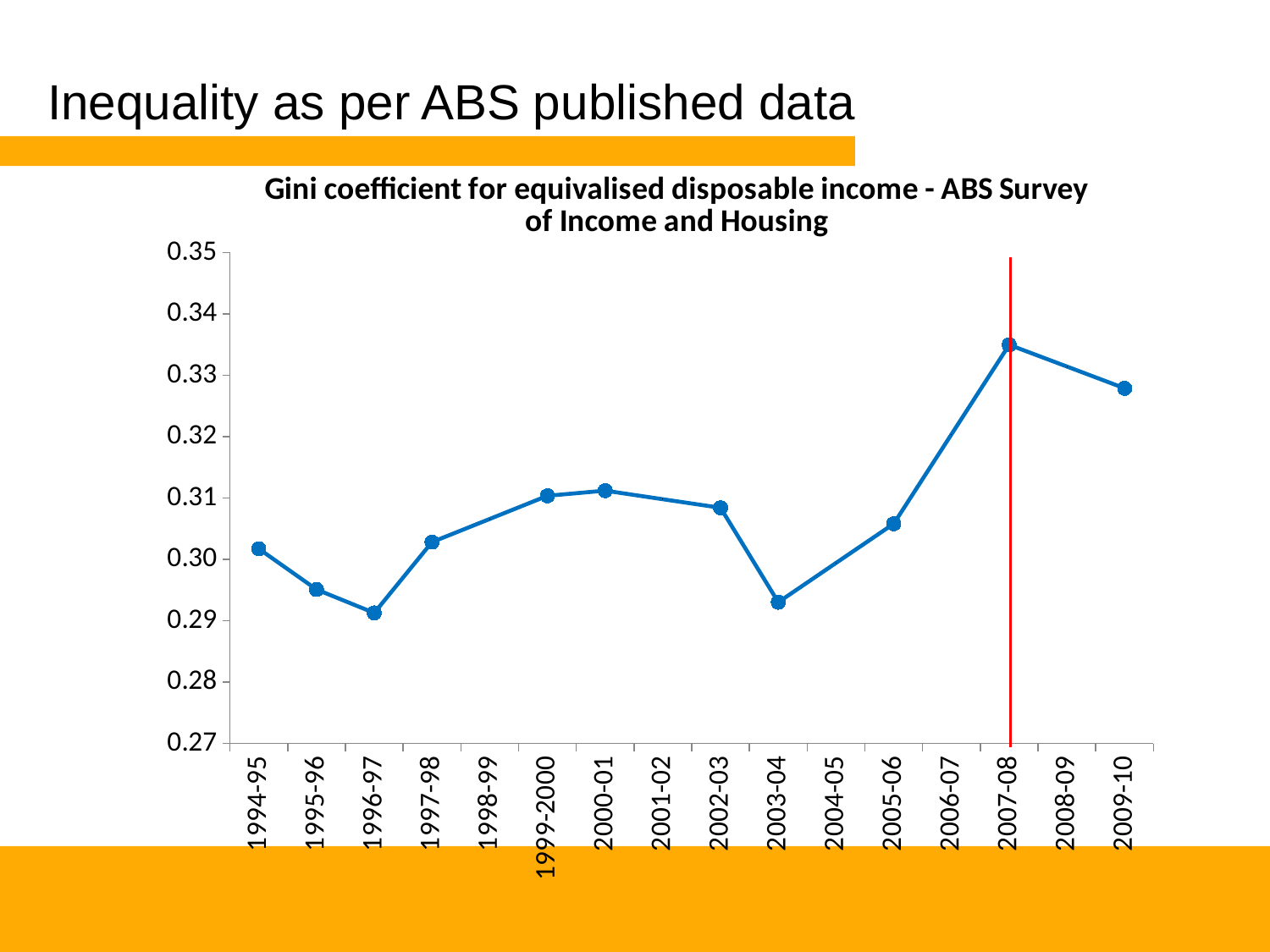
Which year has the lowest Gini coefficient in the chart? 1996-97 Which year has the highest Gini coefficient in the chart? 2007-08 Is the Gini coefficient for 2009-10 greater or less than 0.32? greater Does the Gini coefficient rise or fall between 2003-04 and 2007-08? Rise At which year is the red vertical line drawn on the chart? 2007-08 Which year has the larger Gini coefficient, 2007-08 or 2009-10? 2007-08 Is the Gini coefficient for 1996-97 greater or less than 0.30? less Is the Gini coefficient for 2007-08 greater or less than 0.33? greater Which year has the larger Gini coefficient, 2003-04 or 2005-06? 2005-06 What kind of chart is shown on the slide? Line chart How many data points are plotted on the line? 11